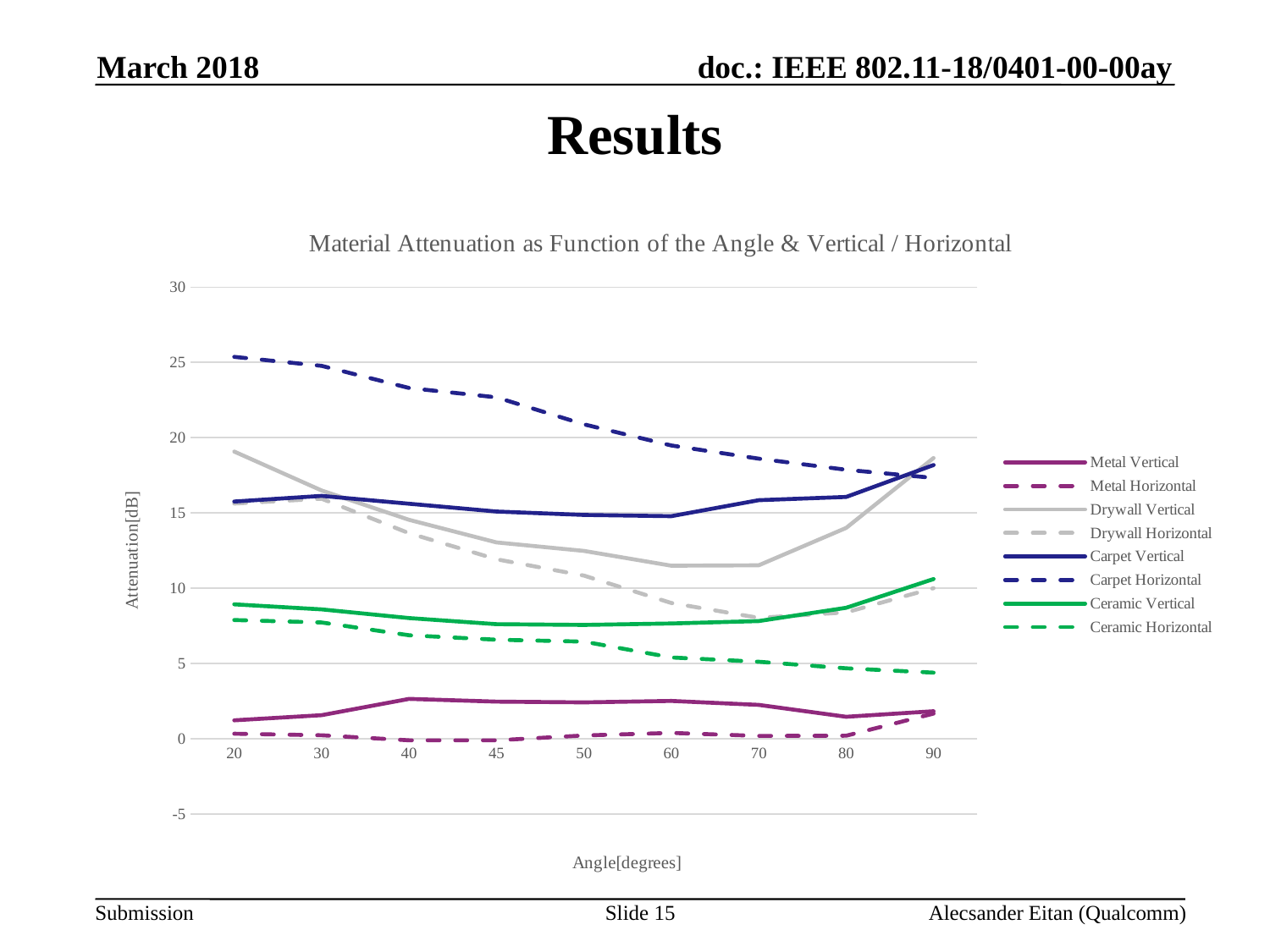
Which series has the highest attenuation at 20 degrees? Carpet Horizontal Which series has the lowest attenuation at 40 degrees? Metal Horizontal At 20 degrees, which is larger: Drywall Vertical or Ceramic Vertical? Drywall Vertical Is the value for Carpet Horizontal at 20 degrees greater or less than 20? greater Does the Carpet Horizontal series rise or fall as the angle increases from 20 to 90 degrees? fall What is the title of the chart? Material Attenuation as Function of the Angle & Vertical / Horizontal What kind of chart is shown on the slide? line chart How many series does the legend list? 8 Is the value for Ceramic Horizontal at 90 degrees greater or less than 5? less How many angle values are marked along the x axis? 9 Is the value for Drywall Vertical at 60 degrees greater or less than 15? less What is the label of the y axis? Attenuation[dB]